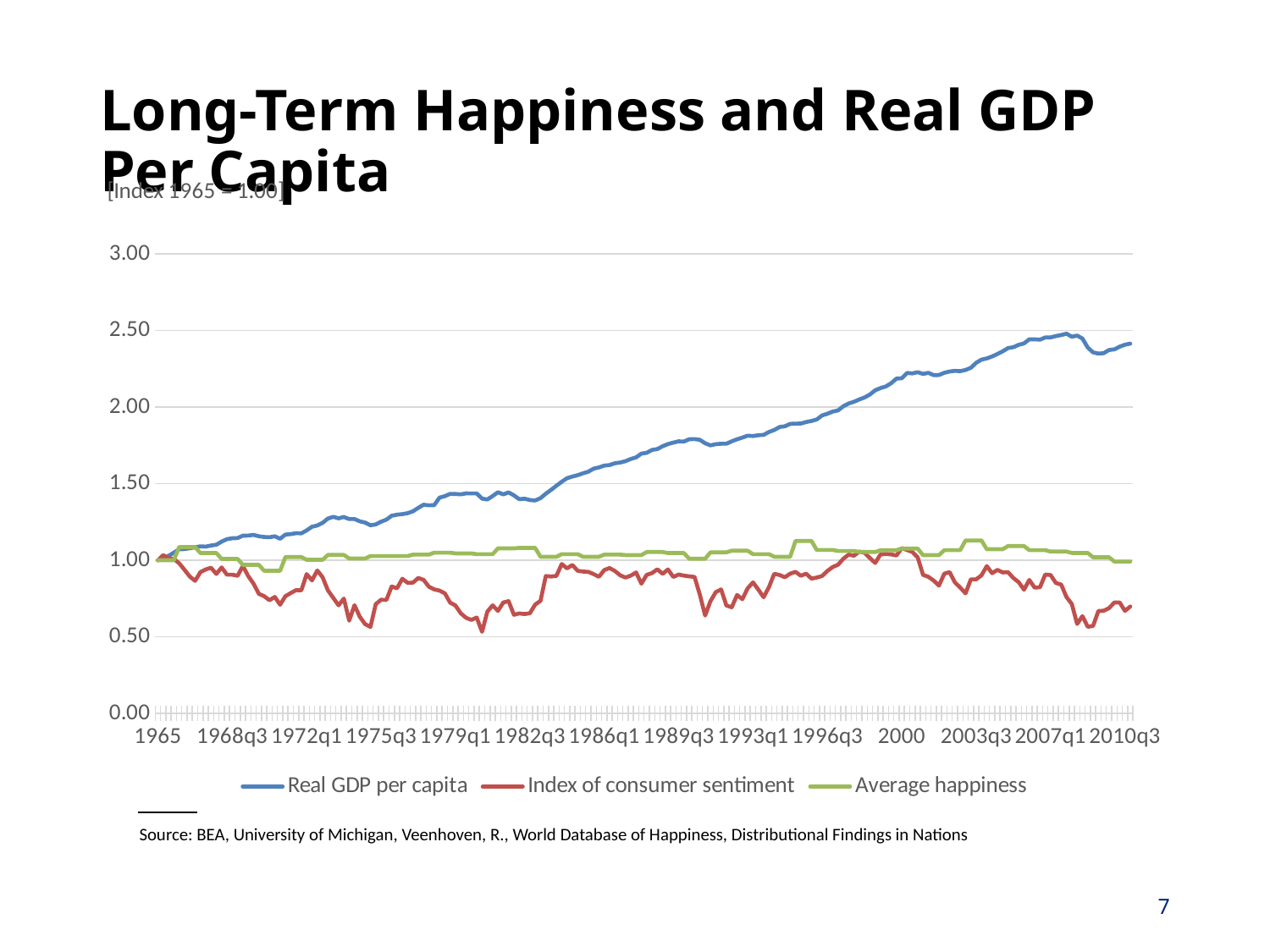
What is the title of the chart on the slide? [Index 1965 = 1.00] Is the value of Real GDP per capita at 2010q3 greater or less than 2.00? greater Is the value of the Index of consumer sentiment at 2010q3 greater or less than 1.00? less What kind of chart is shown on the slide? line chart Does the Real GDP per capita series rise or fall from 1965 to 2010q3? rise Which series has the highest value at 2010q3? Real GDP per capita What is the index value of all three series in the base year 1965? 1.00 Which series has the lowest value at 2010q3? Index of consumer sentiment At 2010q3, which is larger: Real GDP per capita or Average happiness? Real GDP per capita Is the value of Average happiness at 2010q3 greater or less than 1.50? less Which series is drawn in blue? Real GDP per capita How many series does the legend list? 3